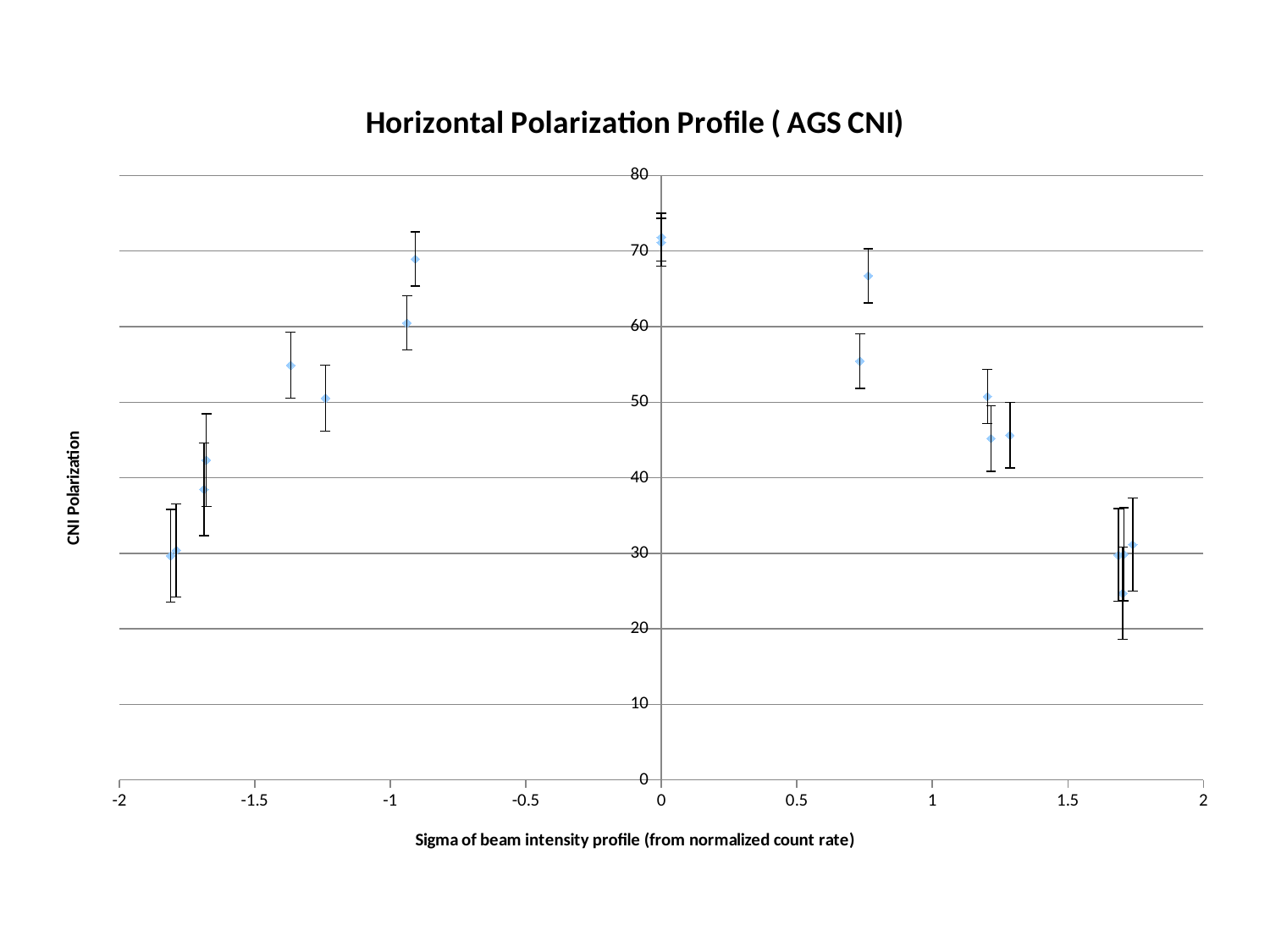
Which has the larger CNI Polarization: the point at sigma 0 or the points near sigma 1.7? The point at sigma 0 Are the CNI Polarization values for the points near sigma 1.7 greater or less than 40? less Is the CNI Polarization value for the point near sigma -1.37 greater or less than 50? greater Which has the larger CNI Polarization: the point near sigma -1.37 or the points near sigma -1.8? The point near sigma -1.37 How do the CNI Polarization values change as sigma increases from -2 to 0? They rise What kind of chart is shown on the slide? Scatter chart What is the title of the chart? Horizontal Polarization Profile ( AGS CNI) How do the CNI Polarization values change as sigma increases from 0 to 2? They fall What is the label of the vertical axis? CNI Polarization Is the CNI Polarization value for the point at sigma 0 greater or less than 60? greater